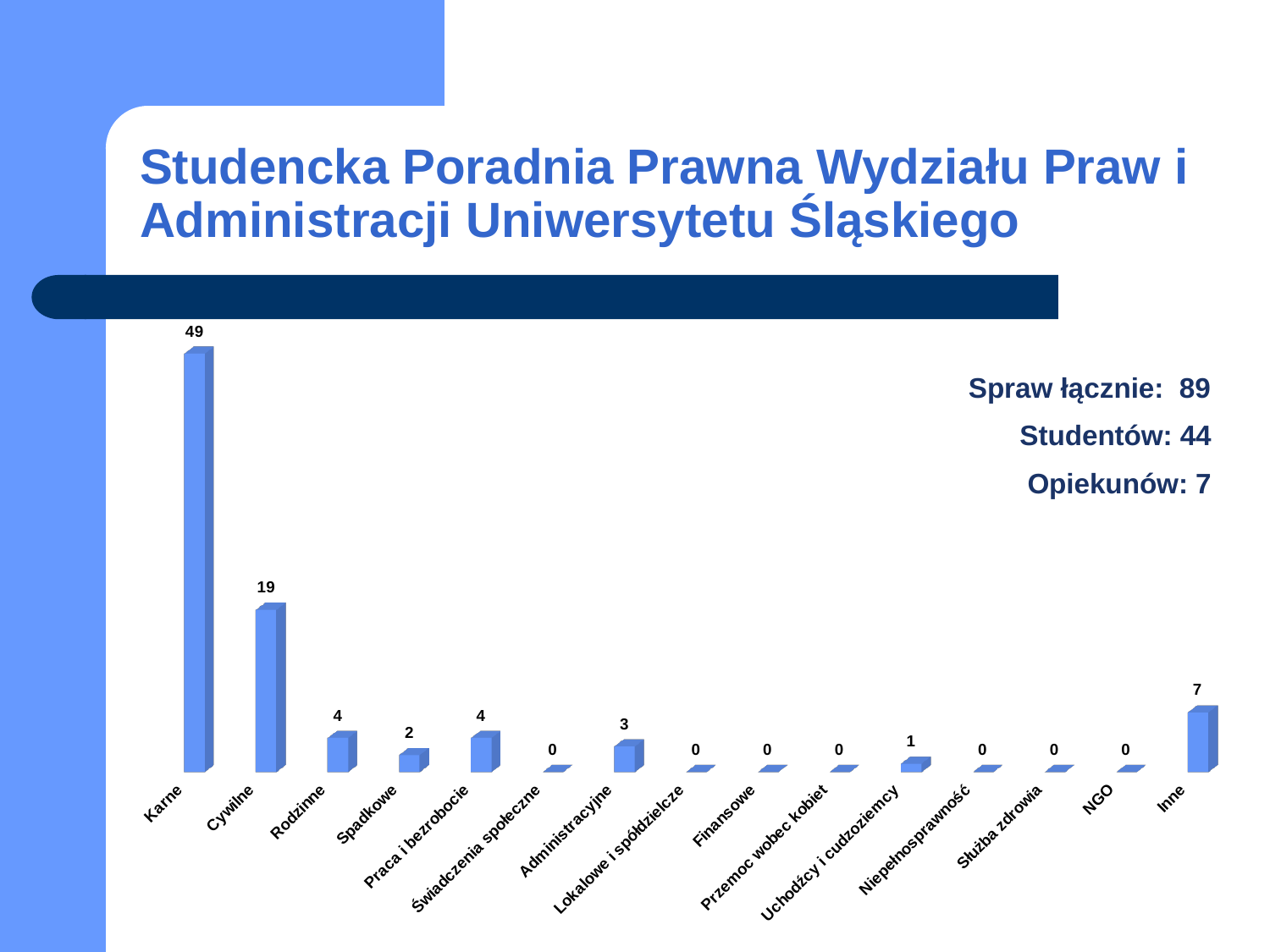
What is the value for Uchodźcy i cudzoziemcy? 1 What kind of chart is shown on the slide? Bar chart What is the value for Administracyjne? 3 How many categories have a value of 0? 7 How many categories are shown on the x axis of the chart? 15 What is the value for Karne? 49 What is the difference between the values for Inne and Spadkowe? 5 What is the value for Inne? 7 What is the difference between the values for Karne and Cywilne? 30 Which is larger, the value for Rodzinne or the value for Spadkowe? Rodzinne What is the value for Cywilne? 19 Which category has the highest value? Karne